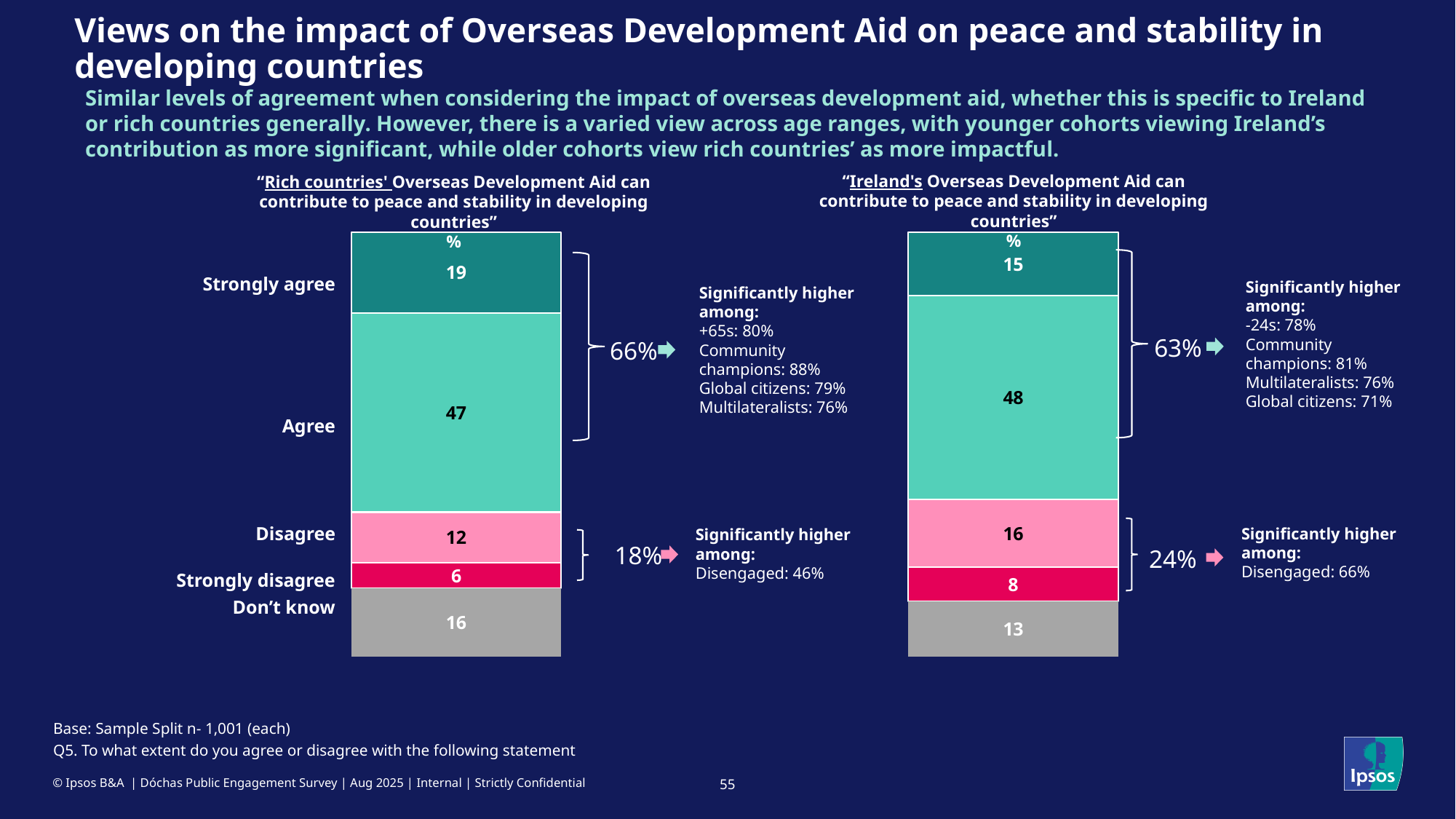
In the "Rich countries' Overseas Development Aid" chart, what percentage of respondents strongly agree? 19 What type of chart is used on this slide? Stacked bar chart How many response categories are shown in each stacked bar? 5 In the "Rich countries' Overseas Development Aid" chart, which response category has the highest value? Agree In the "Rich countries' Overseas Development Aid" chart, what is the difference between the Agree and Strongly agree values? 28 In the "Ireland's Overseas Development Aid" chart, what percentage of respondents answered Don't know? 13 In the "Ireland's Overseas Development Aid" chart, what is the combined total of Disagree and Strongly disagree shown by the bracket? 24% In the "Rich countries' Overseas Development Aid" chart, which group is listed as significantly higher at 88% for agreement? Community champions Which chart has the larger Disagree value, "Rich countries'" or "Ireland's"? Ireland's In the "Rich countries' Overseas Development Aid" chart, what is the combined total of Strongly agree and Agree shown by the bracket? 66% In the "Ireland's Overseas Development Aid" chart, which response category has the lowest value? Strongly disagree In the "Ireland's Overseas Development Aid" chart, what percentage of respondents agree? 48